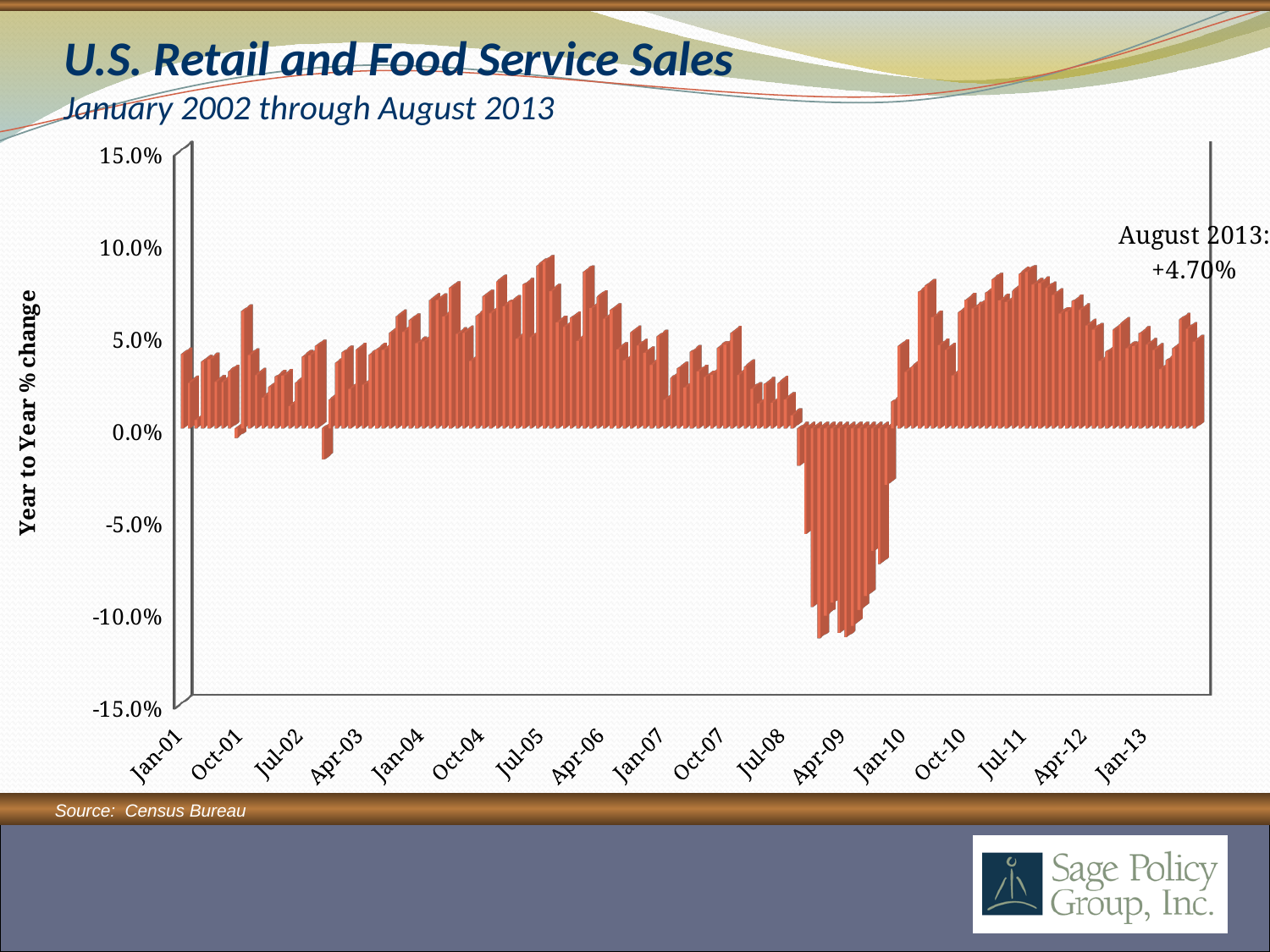
What is the year-to-year % change shown for August 2013? +4.70% Is the value for Jul-08 greater or less than 5.0%? less Is the value for Apr-09 larger or smaller than the value for Jul-11? smaller Is the value for Apr-12 greater or less than 0.0%? greater Is the value for Oct-04 greater or less than 5.0%? greater What is the title of the y axis? Year to Year % change Around which x-axis label do the lowest (most negative) values occur? Apr-09 What is the source cited for the chart? Census Bureau What kind of chart is shown on the slide? bar chart